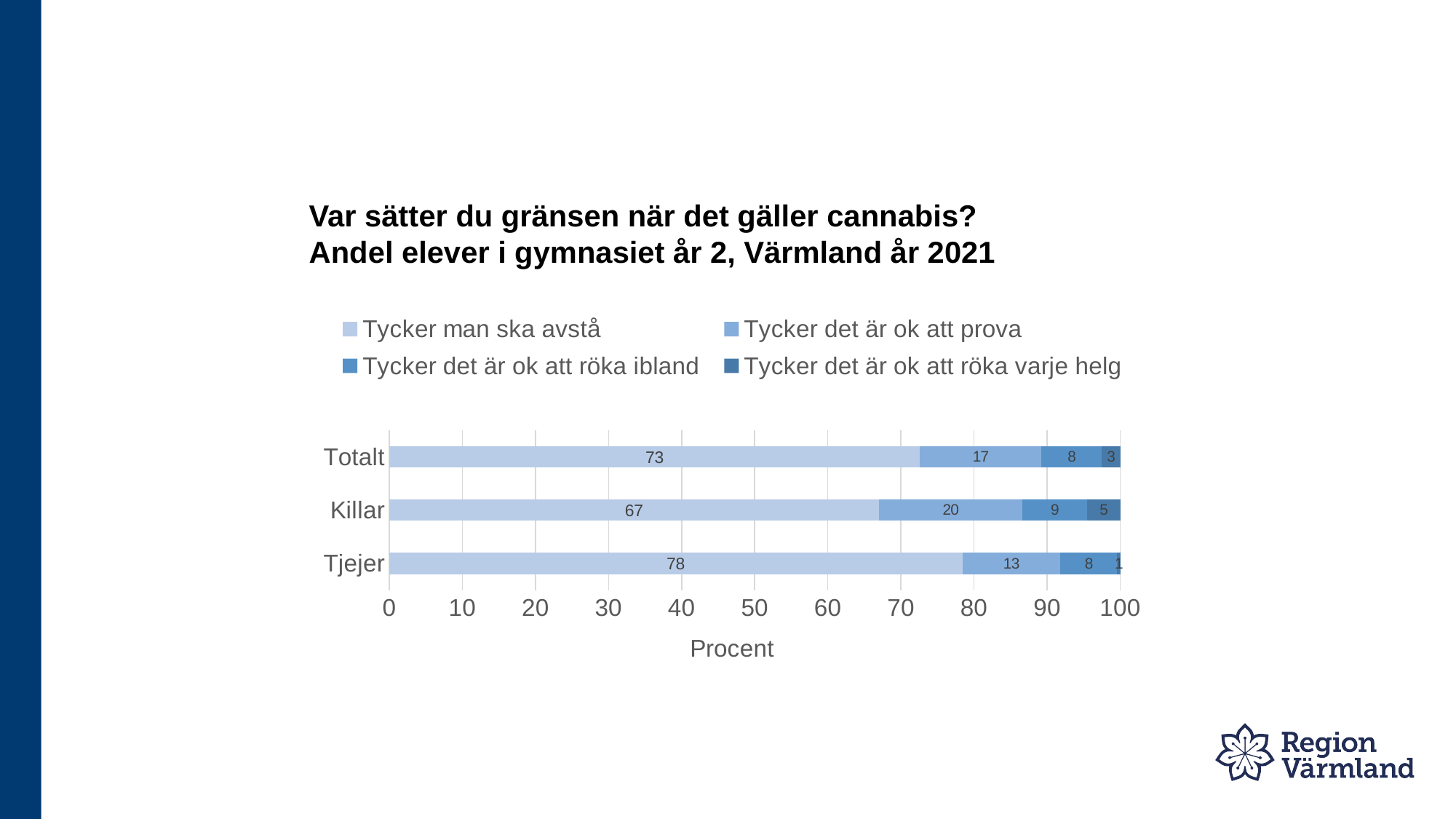
Which is larger: the 'Tycker det är ok att prova' value for Killar or for Totalt? Killar What is the value for 'Tycker det är ok att prova' for Tjejer? 13 What is the label of the horizontal axis? Procent What is the value for 'Tycker det är ok att röka varje helg' for Totalt? 3 What is the value for 'Tycker det är ok att röka ibland' for Killar? 9 What is the value for 'Tycker man ska avstå' for Killar? 67 How many categories are shown on the vertical axis? 3 Which category has the lowest value for 'Tycker det är ok att röka varje helg'? Tjejer How many series does the legend list? 4 Which category has the highest value for 'Tycker man ska avstå'? Tjejer What kind of chart is shown on the slide? Stacked bar chart What is the difference between the 'Tycker man ska avstå' values for Tjejer and Killar? 11